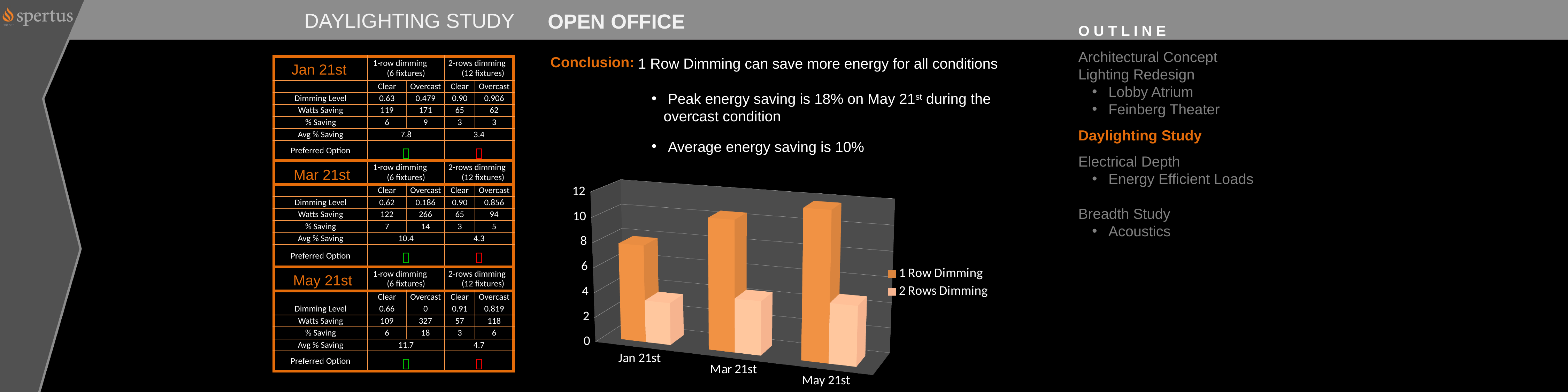
For Jan 21st, which series has the larger value, 1 Row Dimming or 2 Rows Dimming? 1 Row Dimming Do the 1 Row Dimming values rise or fall from Jan 21st to May 21st? rise What kind of chart is shown on the slide? bar chart Which category has the lowest value for 1 Row Dimming? Jan 21st Is the value for 1 Row Dimming on Mar 21st greater or less than 8? greater How many categories are shown on the x axis of the chart? 3 Which series is shown in the lighter colour in the chart legend? 2 Rows Dimming How many series does the chart legend list? 2 Is the value for 1 Row Dimming on Jan 21st greater or less than 6? greater Which category has the lowest value for 2 Rows Dimming? Jan 21st Which category has the highest value for 1 Row Dimming? May 21st Is the value for 2 Rows Dimming on Mar 21st greater or less than 6? less